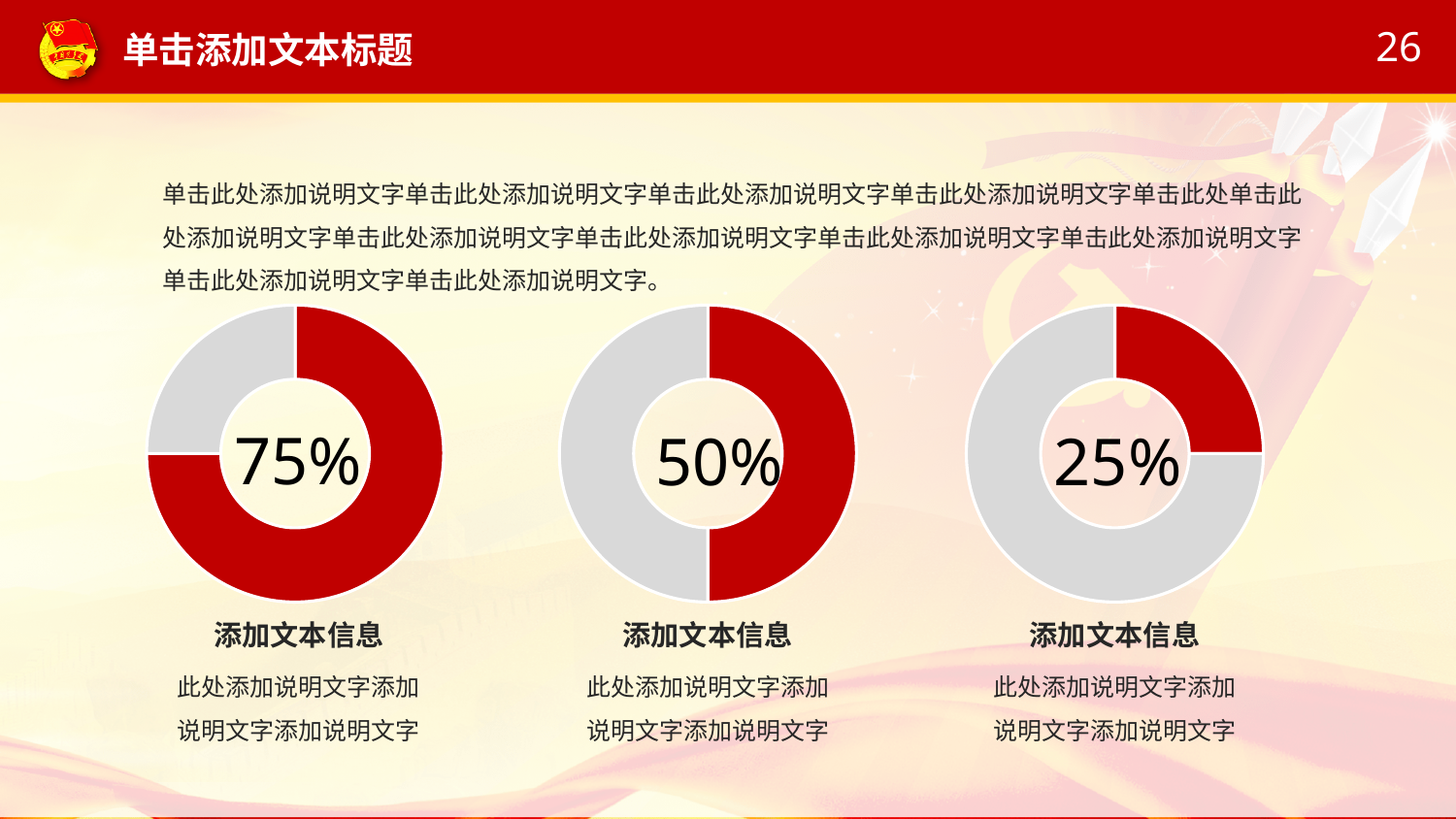
What percentage is shown in the centre of the middle donut chart? 50% Which donut chart shows the lowest percentage, the left, middle or right one? Right Reading the donut charts from left to right, do the percentages rise or fall? Fall What is the difference between the percentage in the left donut chart and the percentage in the middle donut chart? 25% What kind of chart is used for the three charts on the slide? Donut chart What percentage is shown in the centre of the left donut chart? 75% What percentage is shown in the centre of the right donut chart? 25% What colour is the filled (highlighted) portion of each donut chart? Red Which donut chart shows the highest percentage, the left, middle or right one? Left Is the percentage in the middle donut chart larger or smaller than the percentage in the right donut chart? Larger What is the difference between the percentage in the left donut chart and the percentage in the right donut chart? 50% How many donut charts are on the slide? 3